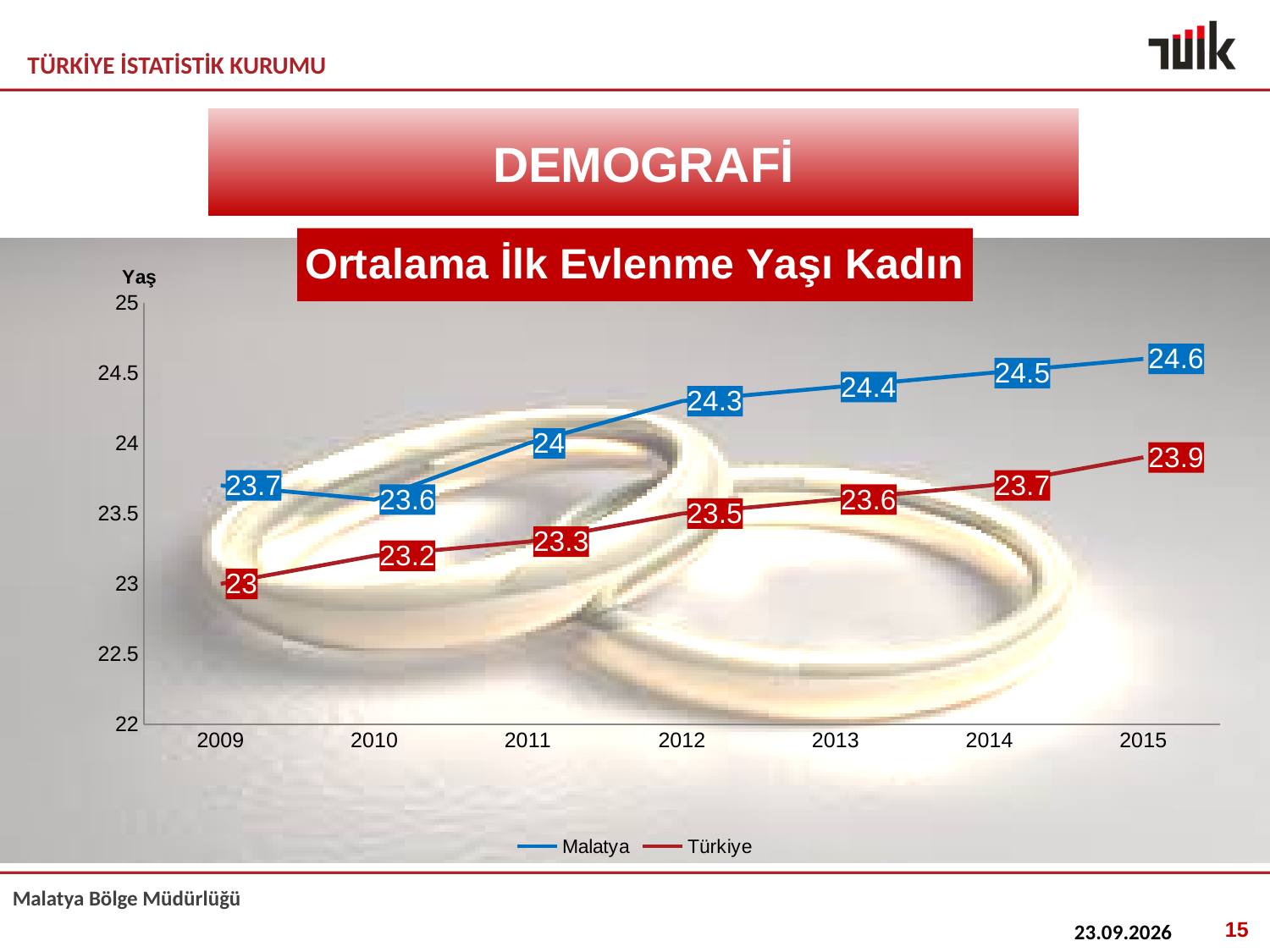
In which year is the Türkiye series at its highest? 2015 In which year is the Malatya series at its lowest? 2010 What is the difference between the Malatya and Türkiye values in 2015? 0.7 What is the value for Türkiye in 2015? 23.9 How many years are shown on the x axis? 7 How many series does the legend list? 2 Does the Türkiye series rise or fall from 2009 to 2015? Rise What is the value for Türkiye in 2009? 23 What is the value for Malatya in 2012? 24.3 Which series has the larger value in 2011, Malatya or Türkiye? Malatya What kind of chart is this? Line chart What is the value for Malatya in 2010? 23.6